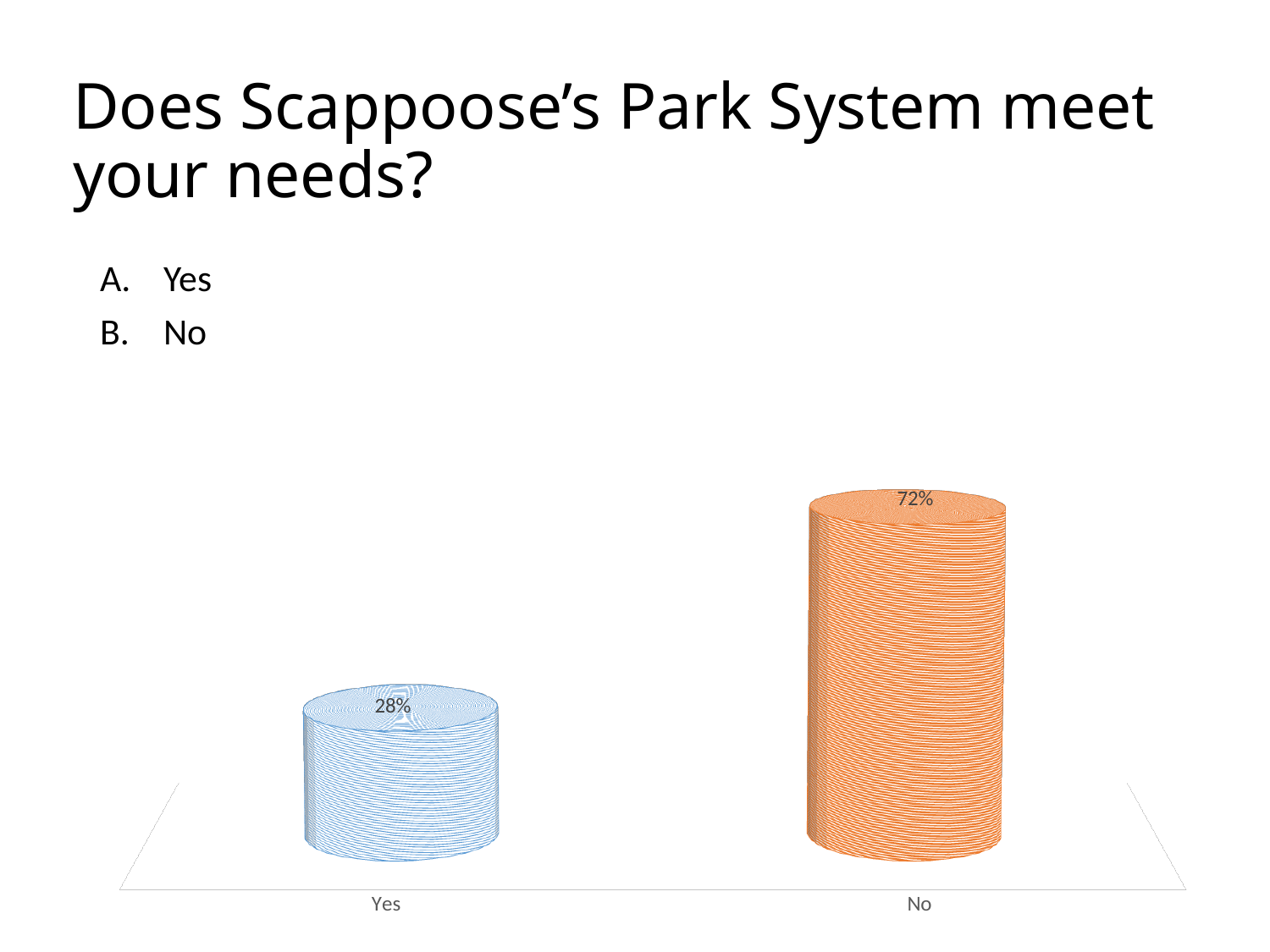
What is the difference in percentage points between the No and Yes responses? 44 Which response received the lowest percentage? Yes What question does the chart on the slide relate to? Does Scappoose's Park System meet your needs? How many categories are shown in the chart? 2 What colour is the bar for the No response? Orange What kind of chart is shown on the slide? Bar chart What is the total of the Yes and No percentages? 100% Which is larger, the value for Yes or the value for No? No What percentage of respondents answered Yes? 28% What percentage of respondents answered No? 72% Which response received the highest percentage? No